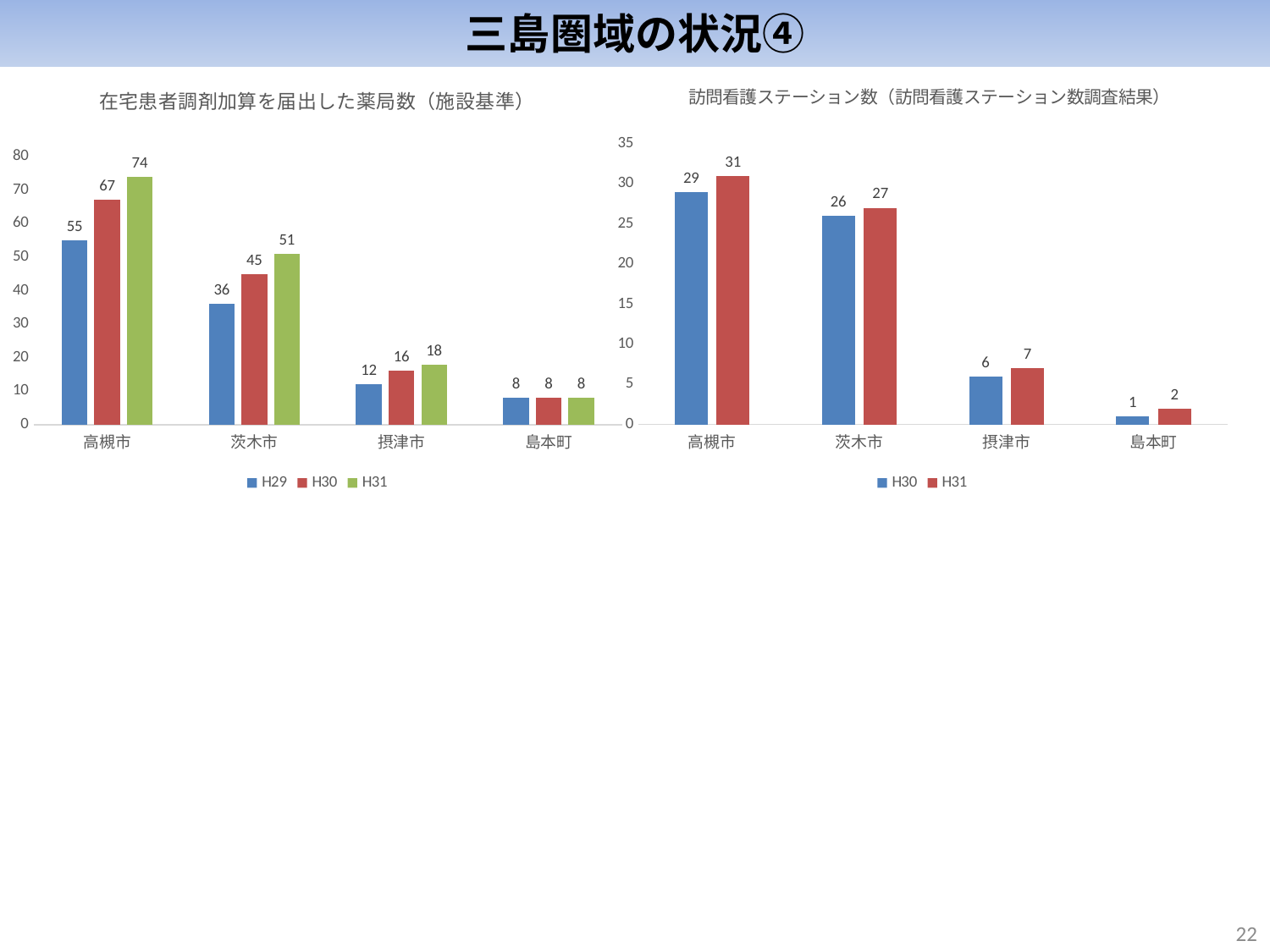
In the right chart (訪問看護ステーション数), which category has the lowest H31 value? 島本町 In the right chart (訪問看護ステーション数), what is the difference between the H31 values for 高槻市 and 茨木市? 4 What kind of chart is the right chart (訪問看護ステーション数)? bar chart In the left chart (在宅患者調剤加算を届出した薬局数), what is the H31 value for 高槻市? 74 In the left chart (在宅患者調剤加算を届出した薬局数), do the values for 島本町 rise, fall, or stay the same from H29 to H31? stay the same In the left chart (在宅患者調剤加算を届出した薬局数), what is the difference between the H31 and H29 values for 摂津市? 6 In the left chart (在宅患者調剤加算を届出した薬局数), what is the H29 value for 茨木市? 36 In the right chart (訪問看護ステーション数), what is the H30 value for 島本町? 1 In the right chart (訪問看護ステーション数), how many categories are shown on the x axis? 4 In the left chart (在宅患者調剤加算を届出した薬局数), which category has the highest H30 value? 高槻市 In the left chart (在宅患者調剤加算を届出した薬局数), how many series does the legend list? 3 In the right chart (訪問看護ステーション数), what is the H31 value for 高槻市? 31